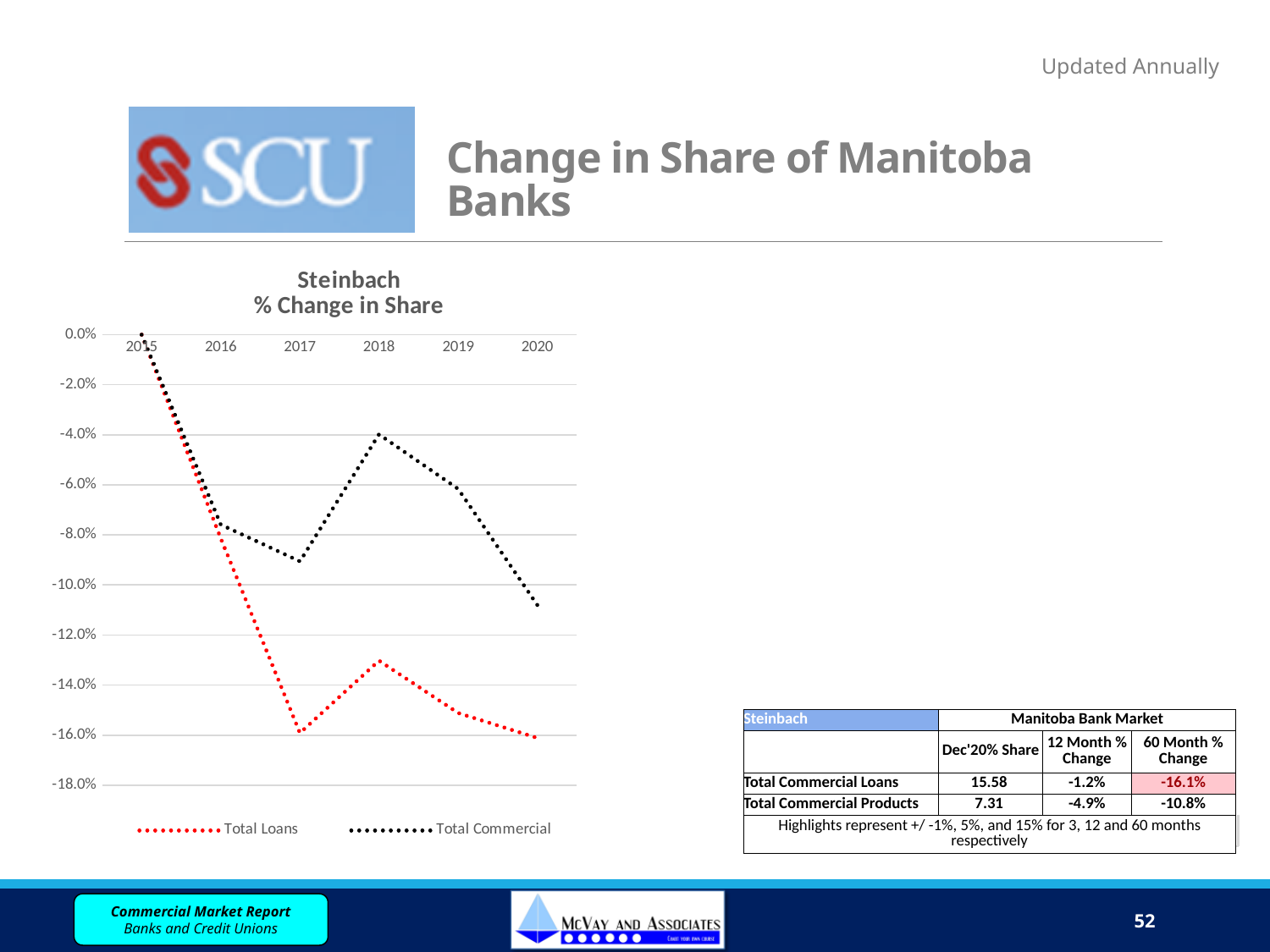
What colour is the Total Loans series in the Steinbach % Change in Share chart? red Is the Total Loans value for 2017 greater or less than -14.0%? less How many years are plotted along the x axis of the Steinbach % Change in Share chart? 6 In which year is the Total Commercial series at its lowest value? 2020 How many series does the legend of the Steinbach % Change in Share chart list? 2 Does the Total Loans series rise or fall from 2015 to 2017? fall In which year is the Total Commercial series at its highest value? 2015 Is the Total Loans value for 2016 greater or less than -6.0%? less Is the Total Commercial value for 2020 greater or less than -10.0%? less What kind of chart is the Steinbach % Change in Share chart? line chart In 2020, which series has the higher value, Total Loans or Total Commercial? Total Commercial